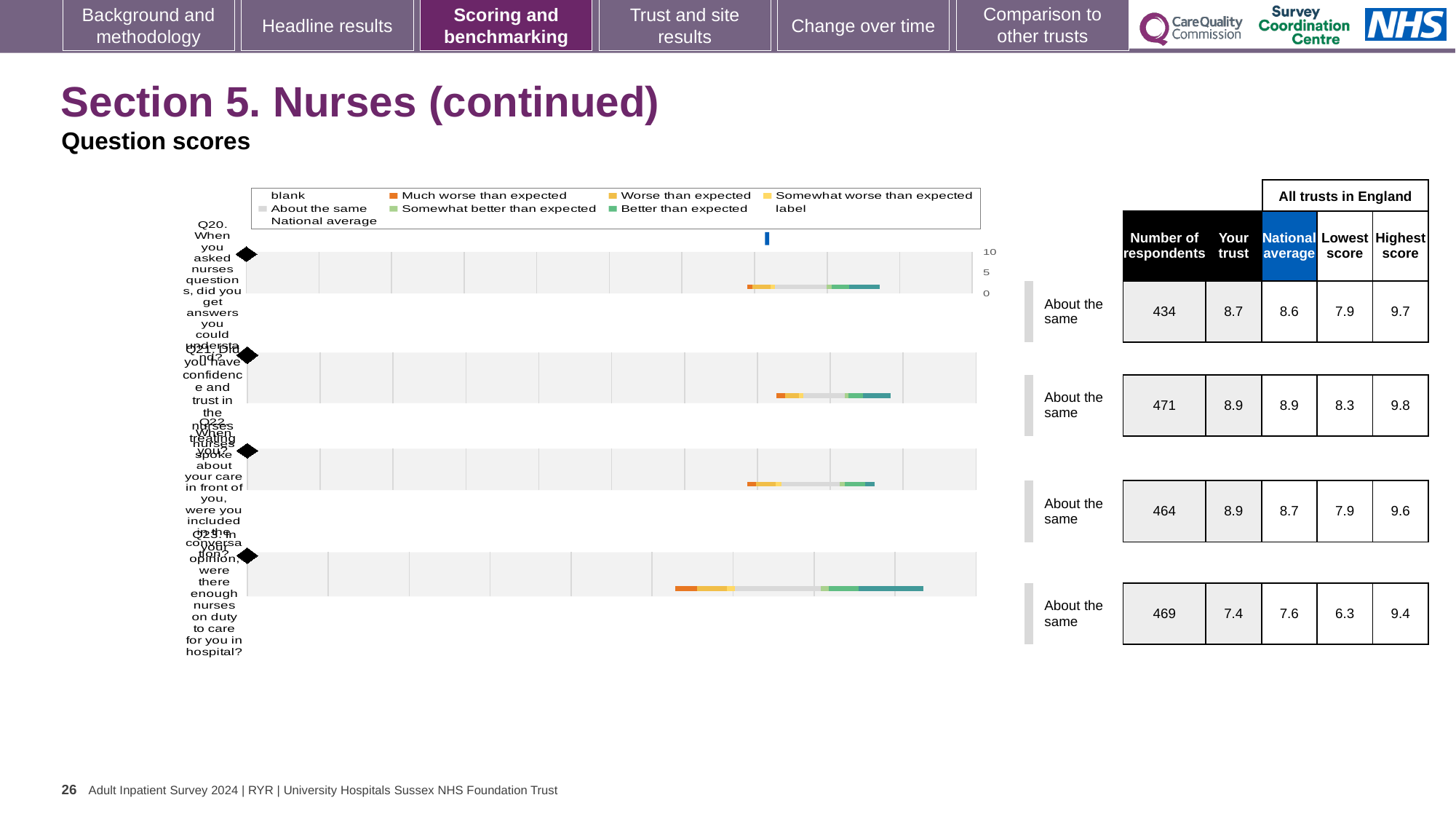
What kind of chart is shown on the slide? bar chart Which question has the lowest 'Your trust' score? Q23 How many respondents answered Q22? 464 How many entries does the chart legend list? 9 What is the difference between the highest score and the lowest score for Q23? 3.1 Which question has the highest number of respondents? Q21 What is the 'Your trust' score for Q23? 7.4 What benchmark category is shown for Q21? About the same How many questions (categories) are plotted in the chart? 4 What is the national average for Q20? 8.6 Is the 'Your trust' value for Q23 greater or less than 5? greater For Q22, which is larger: the 'Your trust' score or the national average? Your trust